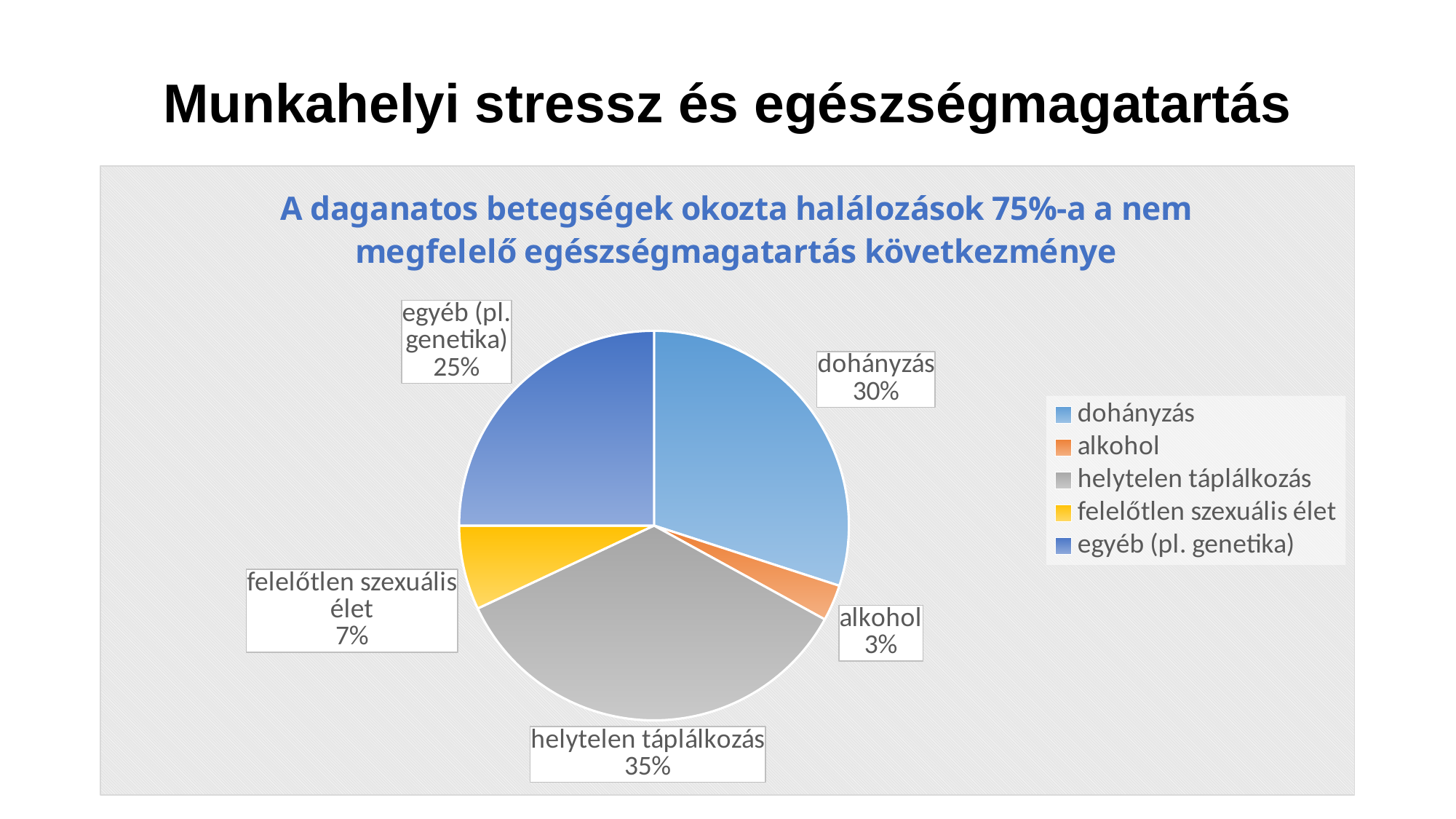
What percentage is shown for alkohol? 3% What percentage is shown for egyéb (pl. genetika)? 25% What percentage is shown for dohányzás? 30% What is the difference in percentage points between helytelen táplálkozás and dohányzás? 5 What kind of chart is shown on the slide? pie chart What colour is the slice for helytelen táplálkozás? grey Which category has the largest share of the pie? helytelen táplálkozás What percentage is shown for felelőtlen szexuális élet? 7% Which category has the smallest share of the pie? alkohol What percentage is shown for helytelen táplálkozás? 35% How many categories does the pie chart have? 5 Which is larger, the share for egyéb (pl. genetika) or the share for felelőtlen szexuális élet? egyéb (pl. genetika)